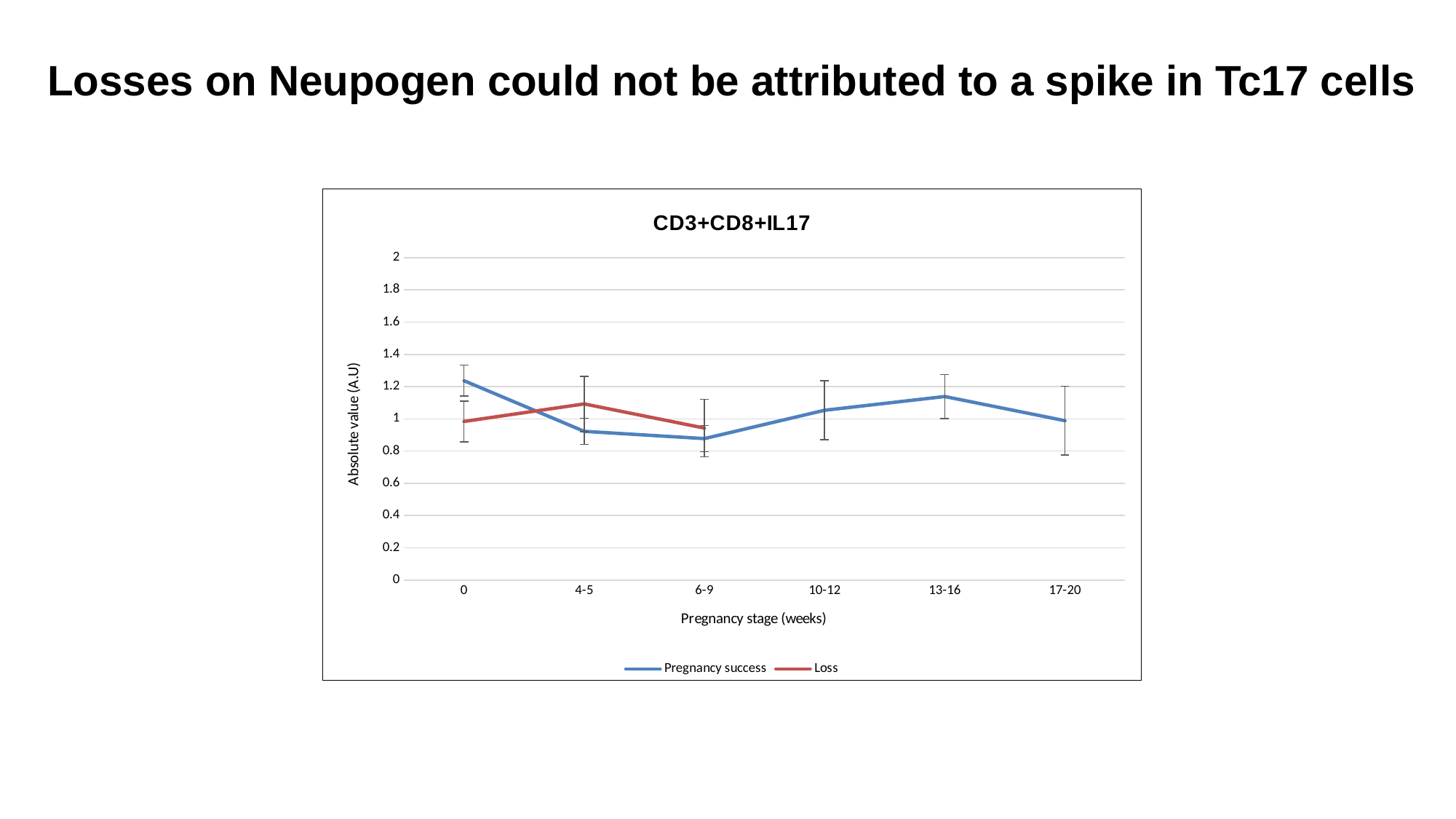
What is the title of the chart? CD3+CD8+IL17 At which pregnancy stage is the Loss series highest? 4-5 Is the value for Pregnancy success at stage 0 greater or less than 1? greater Does the Pregnancy success series rise or fall from stage 0 to stage 4-5? fall Is the value for Loss at stage 4-5 greater or less than 1? greater What kind of chart is shown on the slide? line chart How many series does the legend list? 2 How many pregnancy stage categories are shown on the x axis? 6 What is the label of the y axis? Absolute value (A.U) At stage 4-5, which series has the larger value, Pregnancy success or Loss? Loss At which pregnancy stage is the Pregnancy success series highest? 0 Is the value for Pregnancy success at stage 4-5 greater or less than 1? less